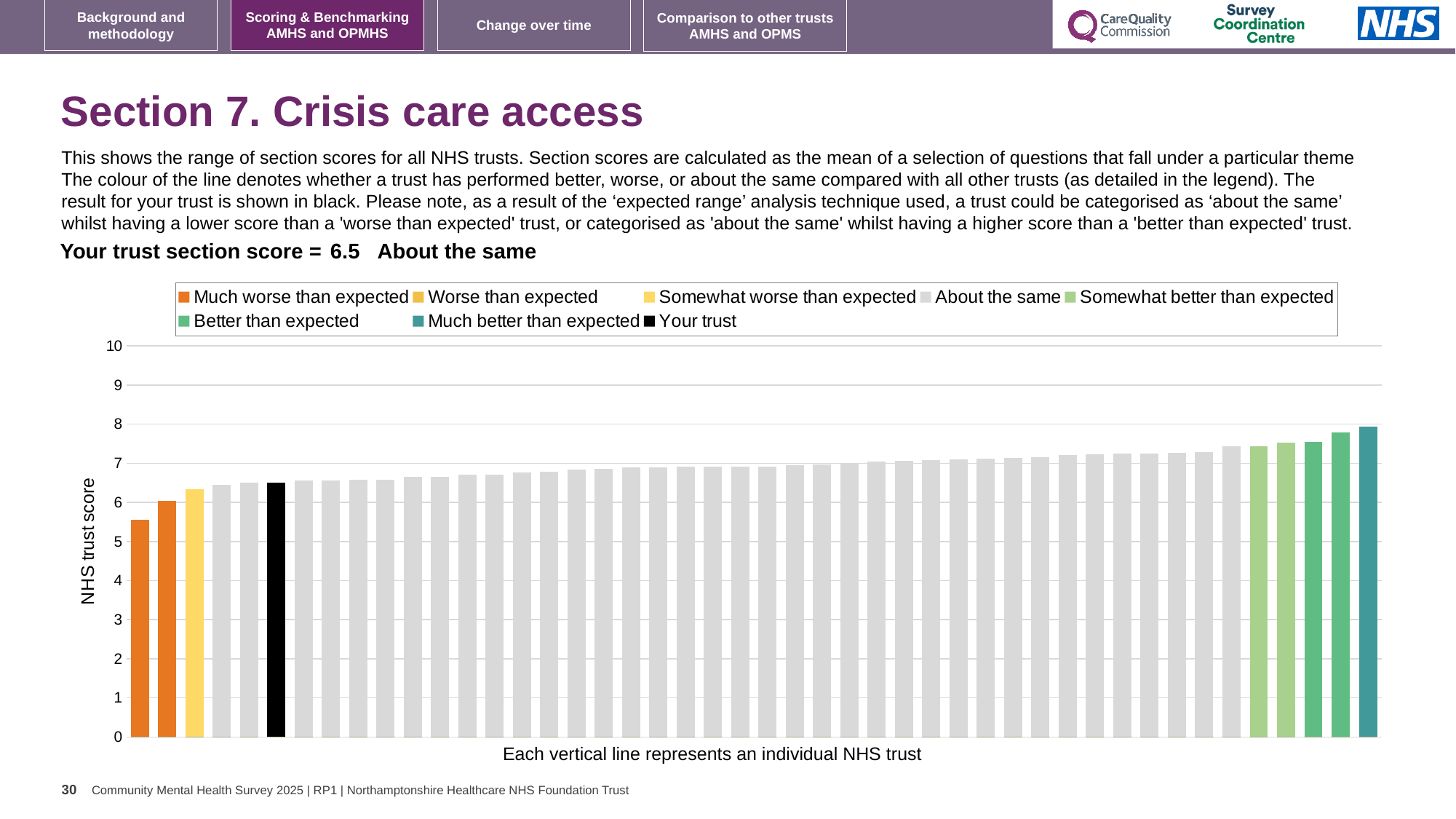
Is the value for the rightmost bar greater or less than 7? greater How many trusts are shown as 'Much worse than expected' (orange bars)? 2 What kind of chart is shown on the slide? bar chart Which category is your trust placed in for this section? About the same Which is larger, the leftmost bar or the rightmost bar? the rightmost bar What colour is the bar representing your trust? black Is the value for the leftmost bar greater or less than 6? less What is the label on the y axis of the chart? NHS trust score What is the section score for your trust? 6.5 Do the bar values rise or fall from left to right along the x axis? rise How many entries does the chart legend list? 8 Is the value for your trust greater or less than 5? greater